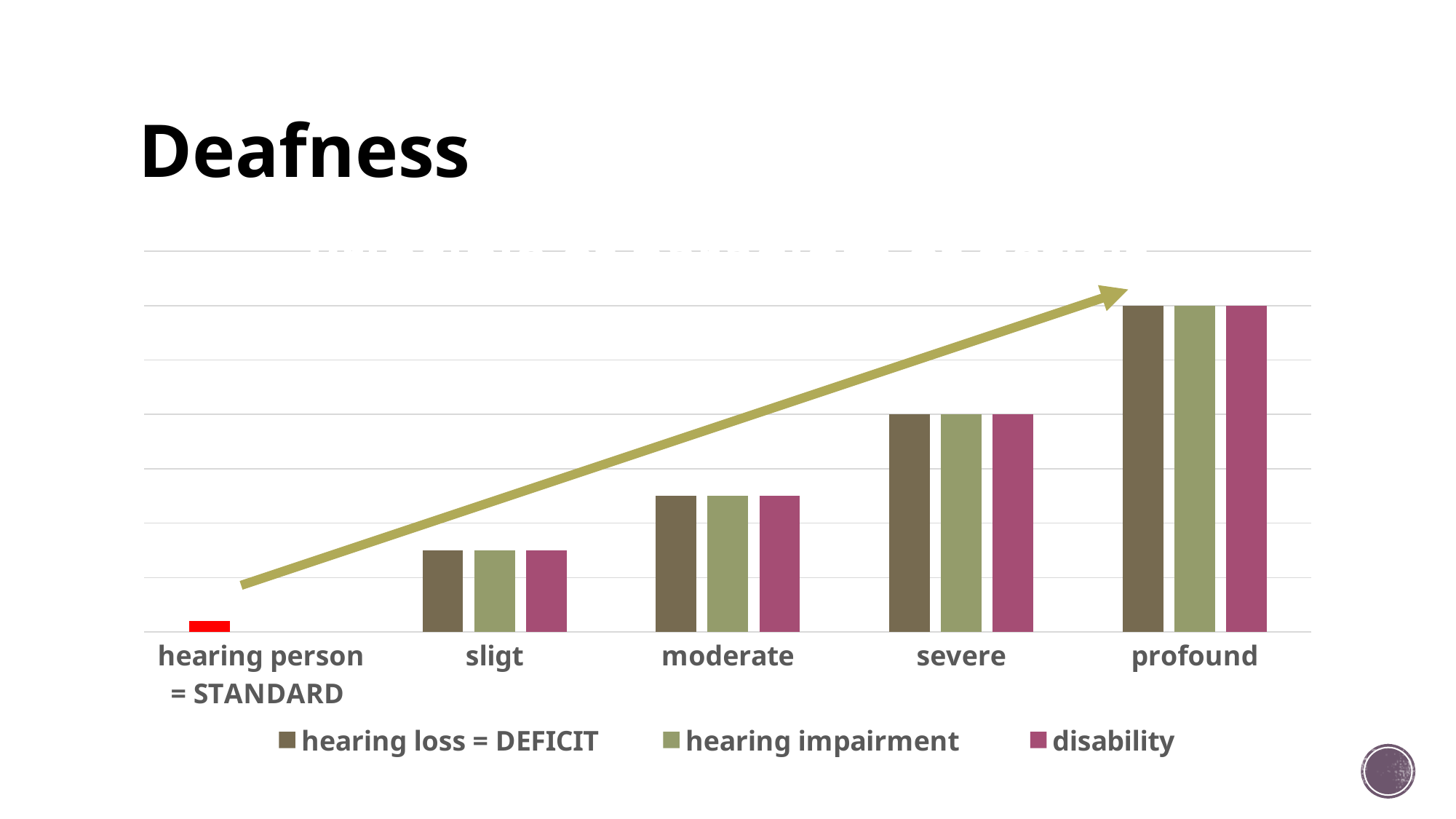
What are the three series named in the chart's legend? hearing loss = DEFICIT, hearing impairment, disability Which category has the lowest bar in the chart? hearing person = STANDARD Which category has taller bars, sligt or profound? profound Do the bar heights rise or fall from left to right along the x axis? rise How many categories are shown along the x axis of the chart? 5 What colour is the bar for the hearing person = STANDARD category? red What kind of chart is shown on the slide? bar chart Which category has taller bars, moderate or sligt? moderate Which category has the tallest bars in the chart? profound How many series does the chart's legend list? 3 Which category has taller bars, severe or moderate? severe